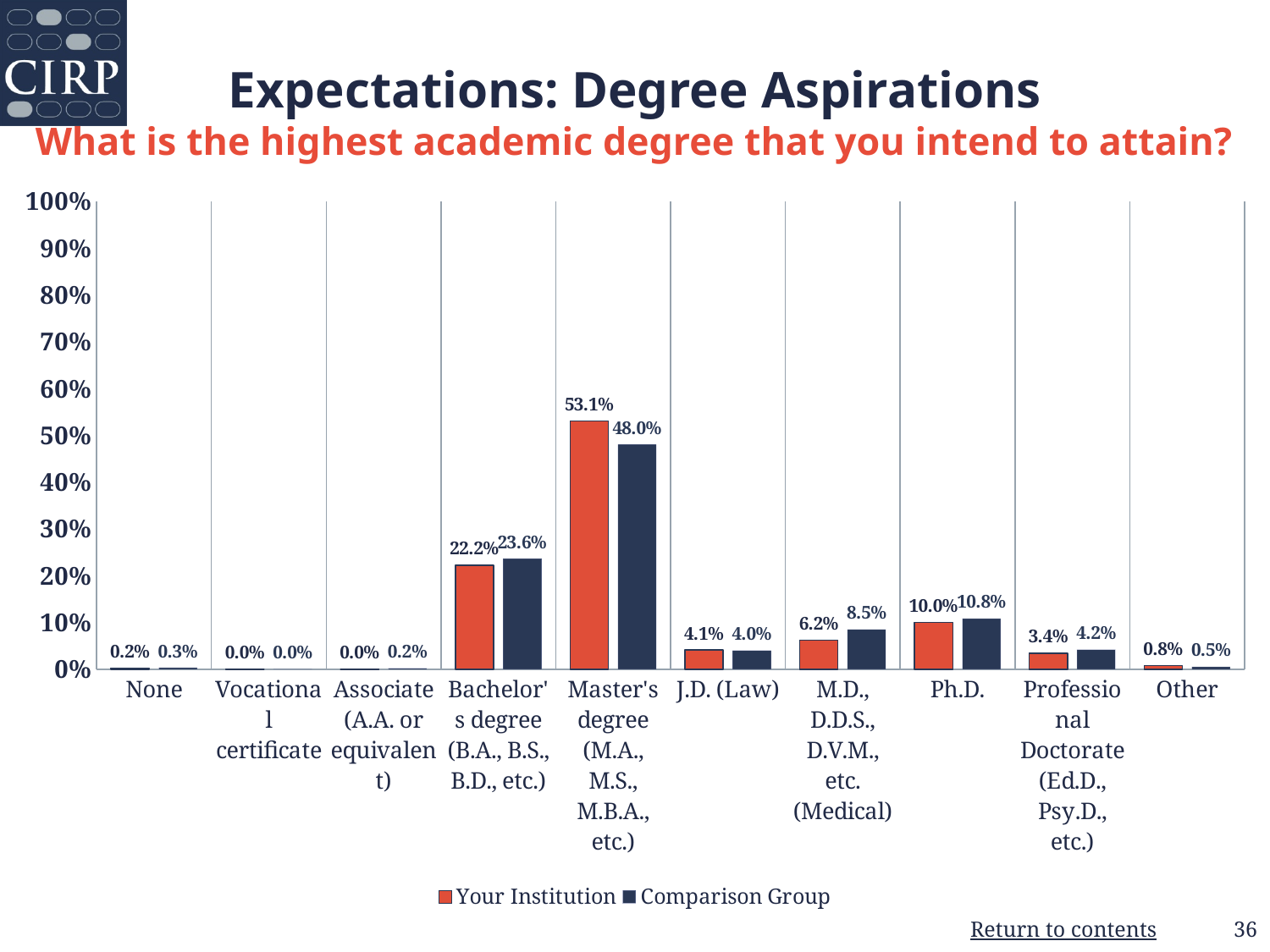
What is the difference between Your Institution and Comparison Group for Master's degree? 5.1% What is the value for Your Institution for M.D., D.D.S., D.V.M., etc. (Medical)? 6.2% How many degree categories are shown on the x axis? 10 What kind of chart is shown on the slide? bar chart What is the value for Comparison Group for Other? 0.5% What is the difference between Comparison Group and Your Institution for Bachelor's degree? 1.4% How many series does the legend list? 2 What is the value for Your Institution for Master's degree? 53.1% Is the value for Your Institution for Bachelor's degree greater or less than 20%? greater What is the value for Comparison Group for Ph.D.? 10.8% Which category has the highest value for Comparison Group? Master's degree Which is larger for M.D., D.D.S., D.V.M., etc. (Medical): Your Institution or Comparison Group? Comparison Group